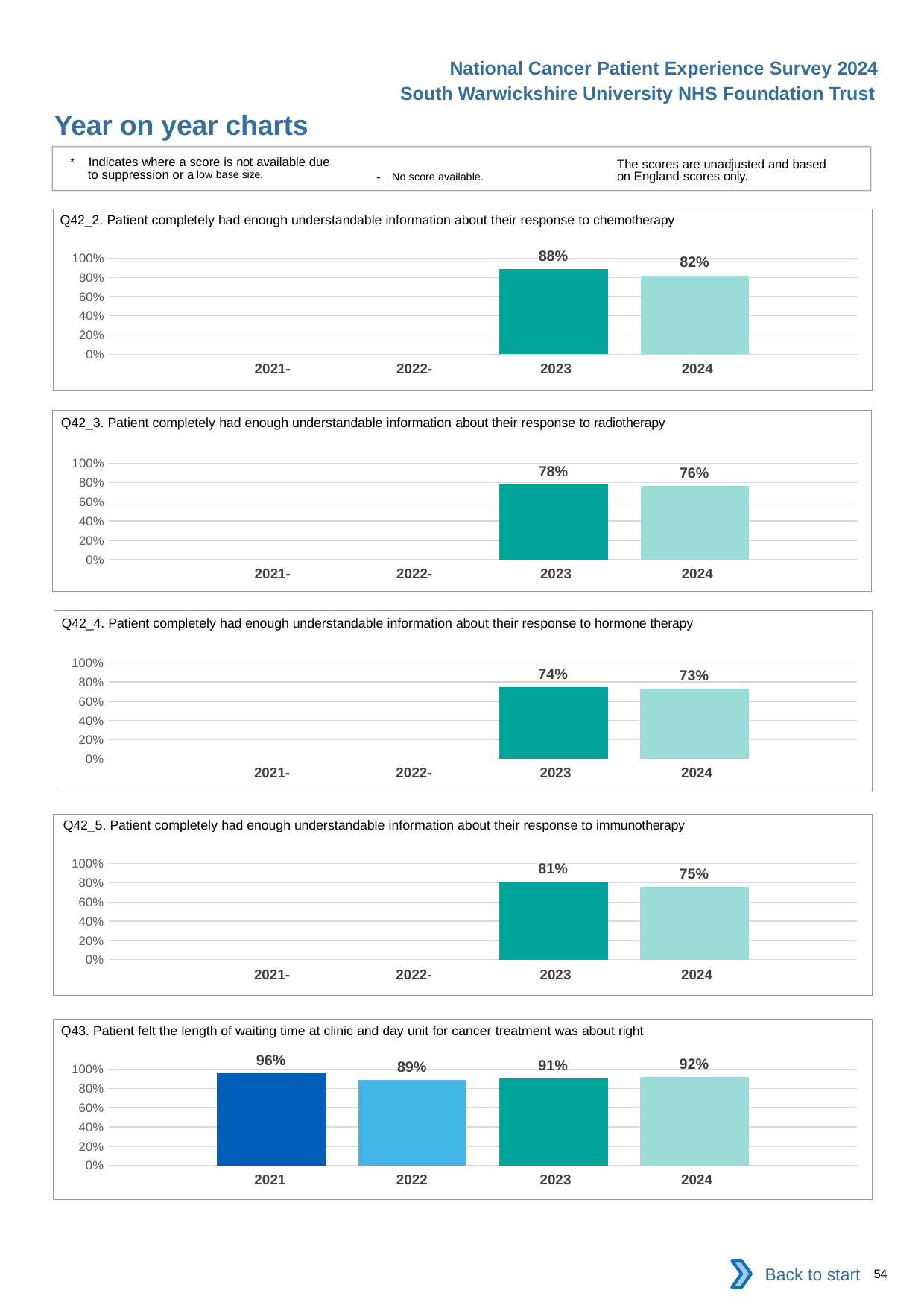
In the Q42_2 chart (chemotherapy), what is the difference between the 2023 and 2024 values? 6% In the Q43 chart (waiting time at clinic and day unit), which year has the lowest value? 2022 In the Q42_2 chart (chemotherapy), what is the value for 2023? 88% In the Q43 chart (waiting time at clinic and day unit), how many years have a bar plotted? 4 In the Q42_3 chart (radiotherapy), which year has the higher value, 2023 or 2024? 2023 In the Q42_3 chart (radiotherapy), what is the value for 2024? 76% In the Q42_4 chart (hormone therapy), what is the value for 2023? 74% In the Q43 chart (waiting time at clinic and day unit), which year has the highest value? 2021 In the Q42_4 chart (hormone therapy), what is the difference between the 2023 and 2024 values? 1% In the Q42_5 chart (immunotherapy), what is the value for 2024? 75% In the Q42_5 chart (immunotherapy), is the value for 2023 greater or less than 80%? greater What kind of chart is the Q43 chart at the bottom of the slide? Bar chart